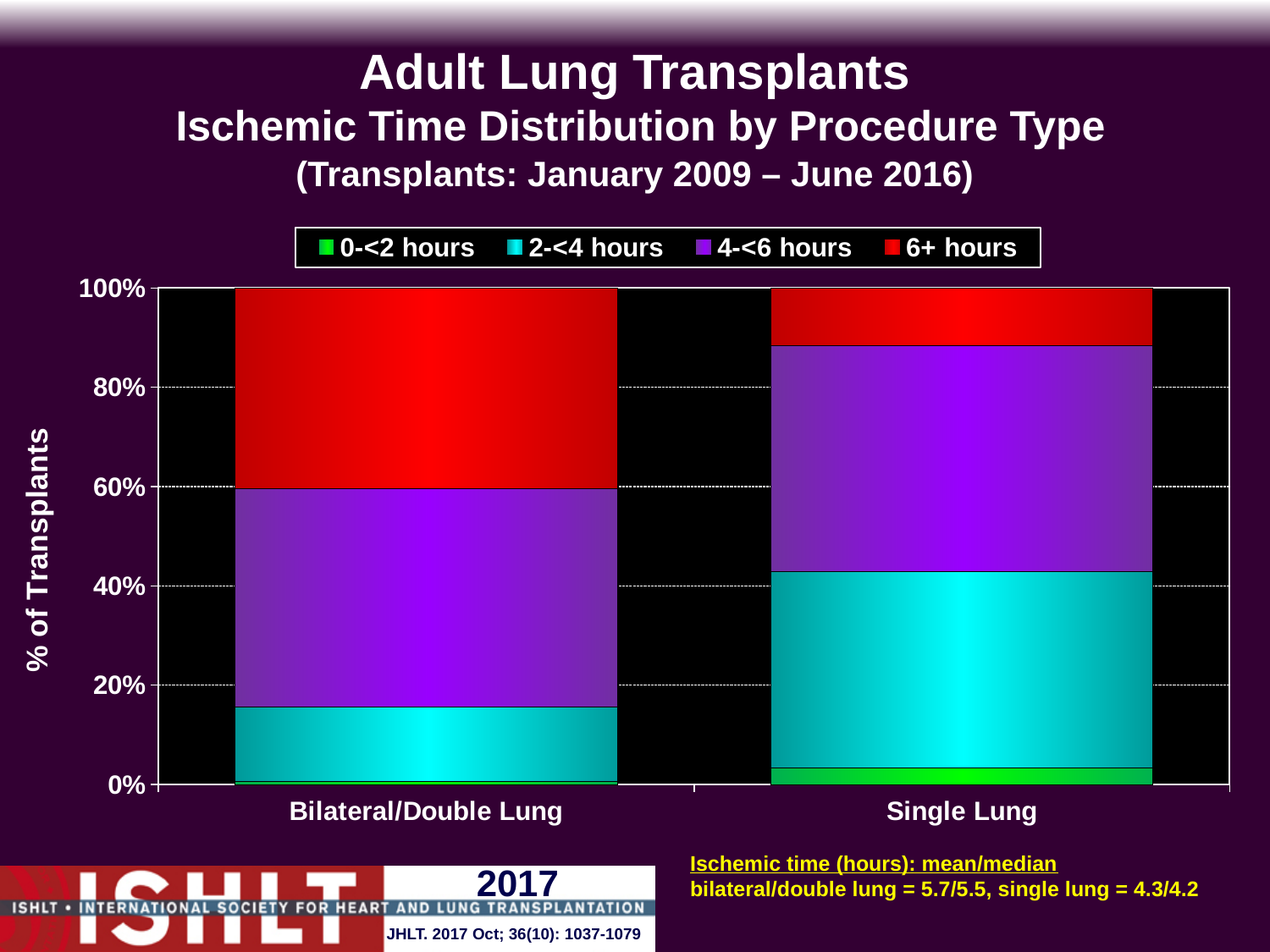
Which procedure type has the larger share of transplants with 0-<2 hours ischemic time? Single Lung Is the share of Single Lung transplants with 6+ hours ischemic time greater or less than 20%? less Is the share of Bilateral/Double Lung transplants with 4-<6 hours ischemic time greater or less than 40%? greater Which procedure type has the larger share of transplants with 6+ hours ischemic time? Bilateral/Double Lung Which procedure type has the larger share of transplants with 2-<4 hours ischemic time? Single Lung How many procedure type categories are shown on the x axis? 2 What kind of chart is shown on the slide? Stacked bar chart Is the share of Single Lung transplants with 2-<4 hours ischemic time greater or less than 20%? greater What is the label on the y axis of the chart? % of Transplants Which colour represents the 6+ hours series in the legend? Red How many series does the legend list? 4